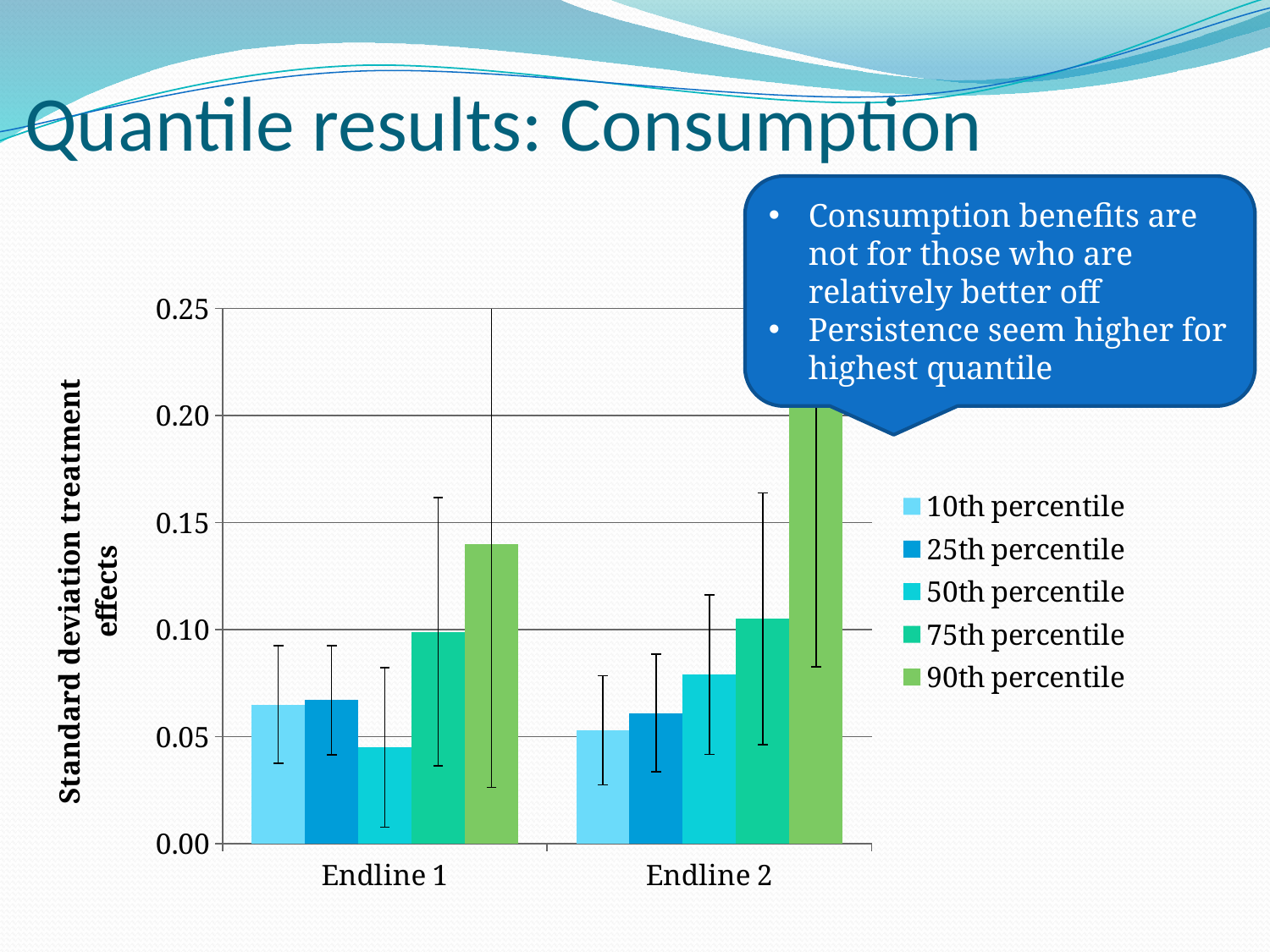
Is the value for the 10th percentile at Endline 2 greater or less than 0.10? less Which percentile has the highest value for Endline 1? 90th percentile What kind of chart is shown on the slide? bar chart Which percentile has the highest value for Endline 2? 90th percentile What is the title of the y axis? Standard deviation treatment effects For the 90th percentile, which is larger: Endline 1 or Endline 2? Endline 2 Is the value for the 90th percentile at Endline 1 greater or less than 0.10? greater How many categories are shown on the x axis? 2 Is the value for the 90th percentile at Endline 2 greater or less than 0.15? greater How many series does the legend list? 5 Which percentile has the lowest value for Endline 1? 50th percentile